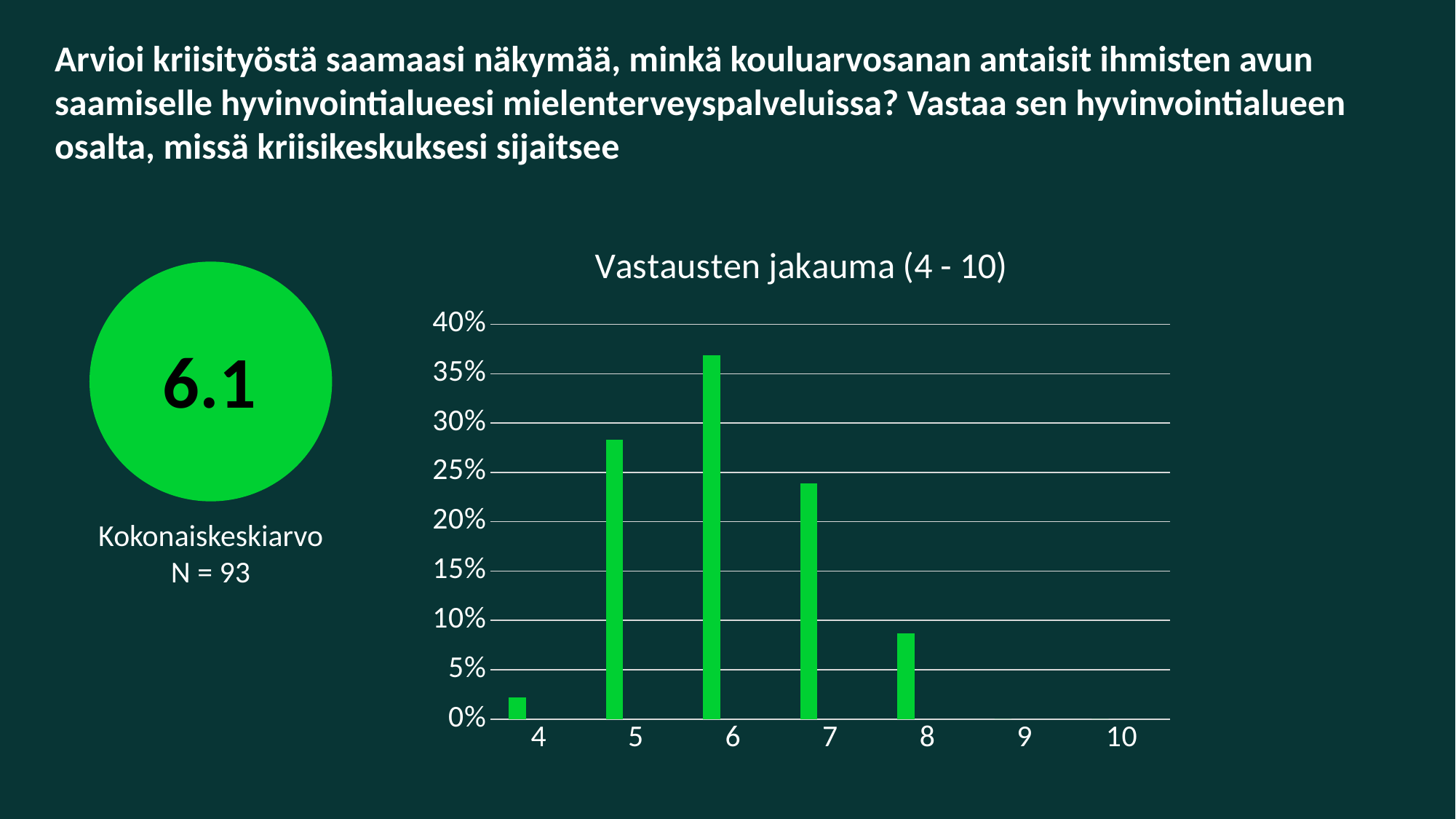
Is the value for category 4 greater or less than 5%? less Is the value for category 6 greater or less than 35%? greater Is the value for category 7 greater or less than 25%? less What overall average (Kokonaiskeskiarvo) is shown in the circle on the slide? 6.1 How many categories are shown on the x axis of the chart? 7 What is the title of the chart? Vastausten jakauma (4 - 10) What kind of chart is shown on the slide? bar chart Which has the larger value, category 5 or category 7? 5 Do the values rise or fall from category 6 to category 8? fall Which category has the highest value in the chart? 6